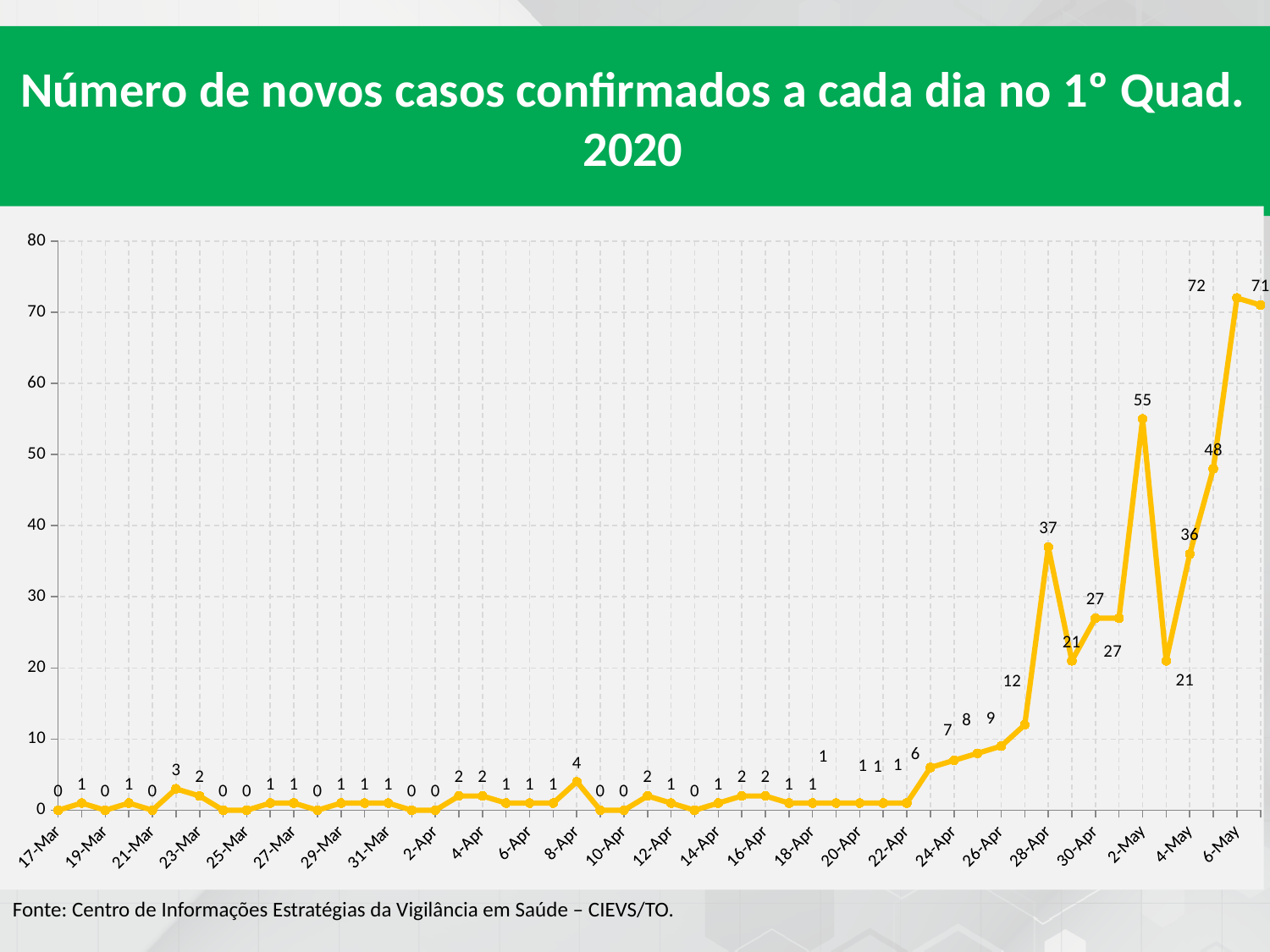
What is the number of new confirmed cases on 2-May? 55 Overall, do the values rise or fall from 17-Mar to the end of the x axis? rise What is the difference between the values on 28-Apr and 26-Apr? 28 What is the number of new confirmed cases on 6-May? 72 What is the difference between the values on 6-May and 2-May? 17 What is the title of the chart? Número de novos casos confirmados a cada dia no 1º Quad. 2020 What kind of chart is shown on the slide? line chart What is the number of new confirmed cases on 28-Apr? 37 Which date has the larger value, 4-May or 2-May? 2-May On which date is the number of new confirmed cases highest? 6-May What is the number of new confirmed cases on 4-May? 36 What is the number of new confirmed cases on 8-Apr? 4